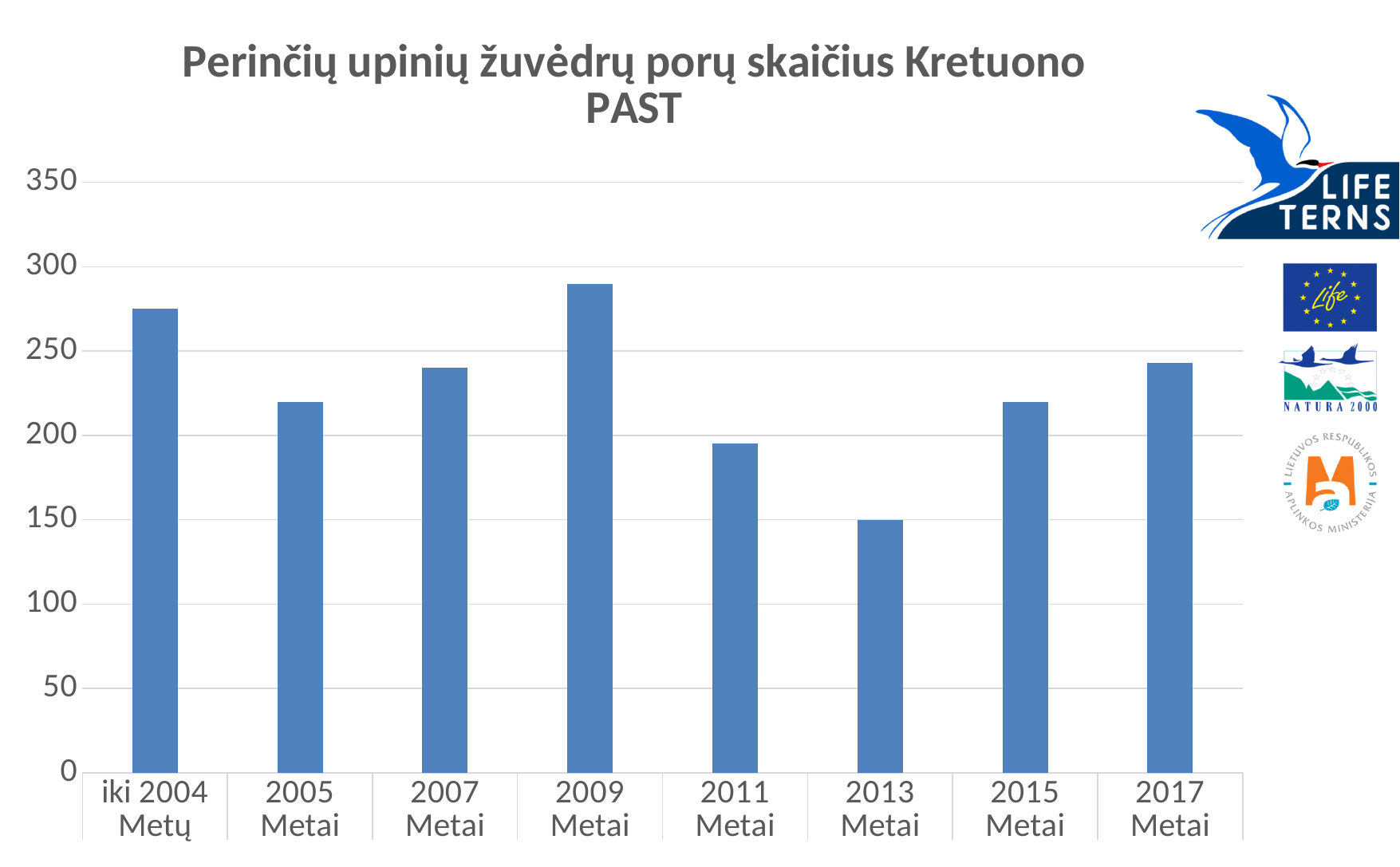
Which category has the highest value? 2009 Metai What type of chart is shown on the slide? bar chart What is the highest value shown on the vertical axis? 350 Which is larger, the value for iki 2004 Metų or the value for 2017 Metai? iki 2004 Metų Which is larger, the value for 2007 Metai or the value for 2011 Metai? 2007 Metai Which category has the lowest value? 2013 Metai What is the title of the chart? Perinčių upinių žuvėdrų porų skaičius Kretuono PAST Is the value for iki 2004 Metų greater or less than 250? greater How many categories (bars) are shown on the chart? 8 Is the value for 2011 Metai greater or less than 200? less Is the value for 2009 Metai greater or less than 250? greater